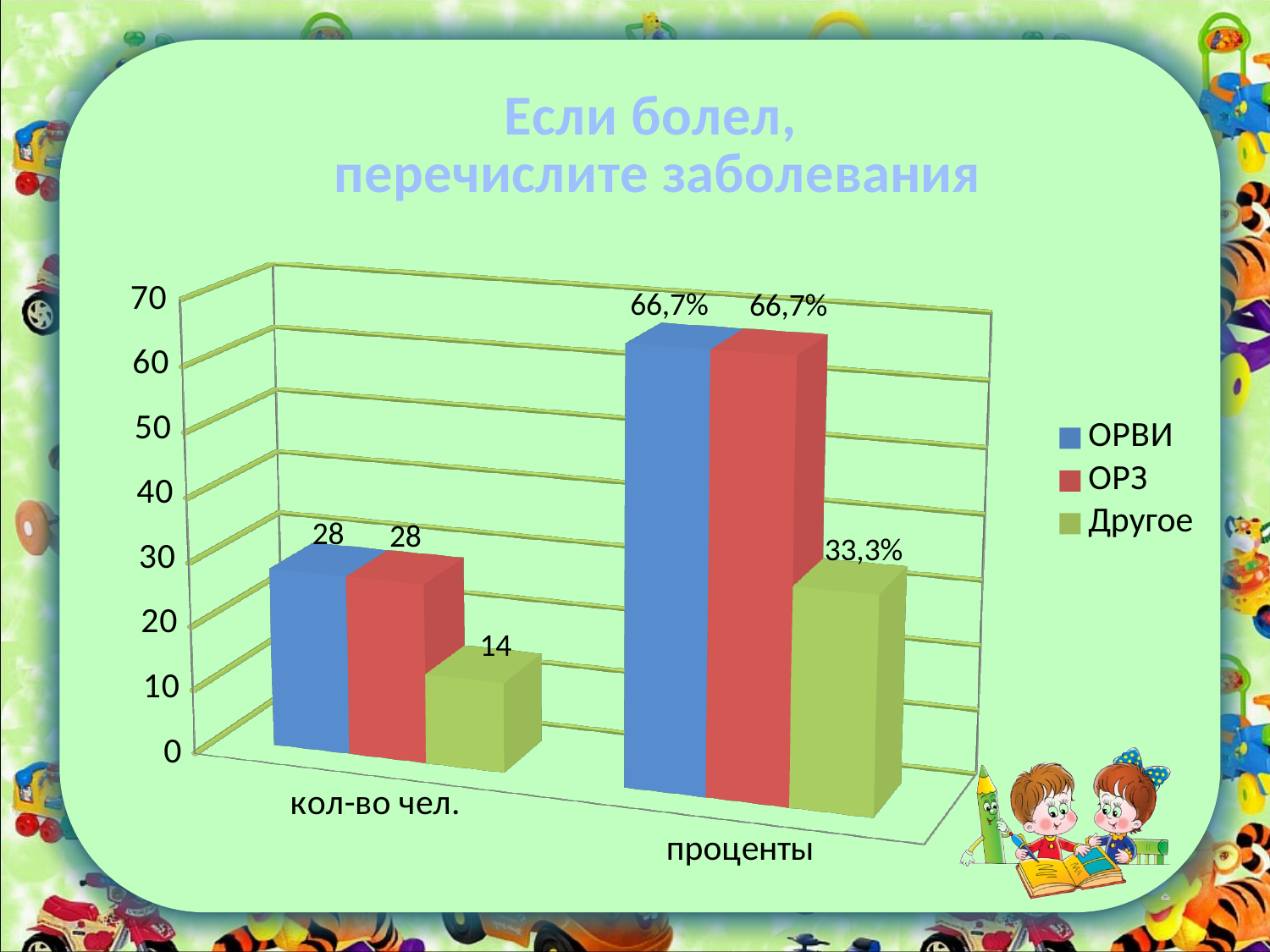
Which is larger in the проценты category: ОРЗ or Другое? ОРЗ What is the value for Другое in the кол-во чел. category? 14 What is the difference between the ОРВИ and Другое values in the кол-во чел. category? 14 What is the value for Другое in the проценты category? 33,3% What kind of chart is shown on the slide? Bar chart What is the value for ОРВИ in the кол-во чел. category? 28 How many categories are shown on the x axis? 2 What is the value for ОРЗ in the проценты category? 66,7% What is the title of the chart? Если болел, перечислите заболевания How many series does the legend list? 3 Which series has the lowest value in the кол-во чел. category? Другое What colour represents the ОРЗ series? Red